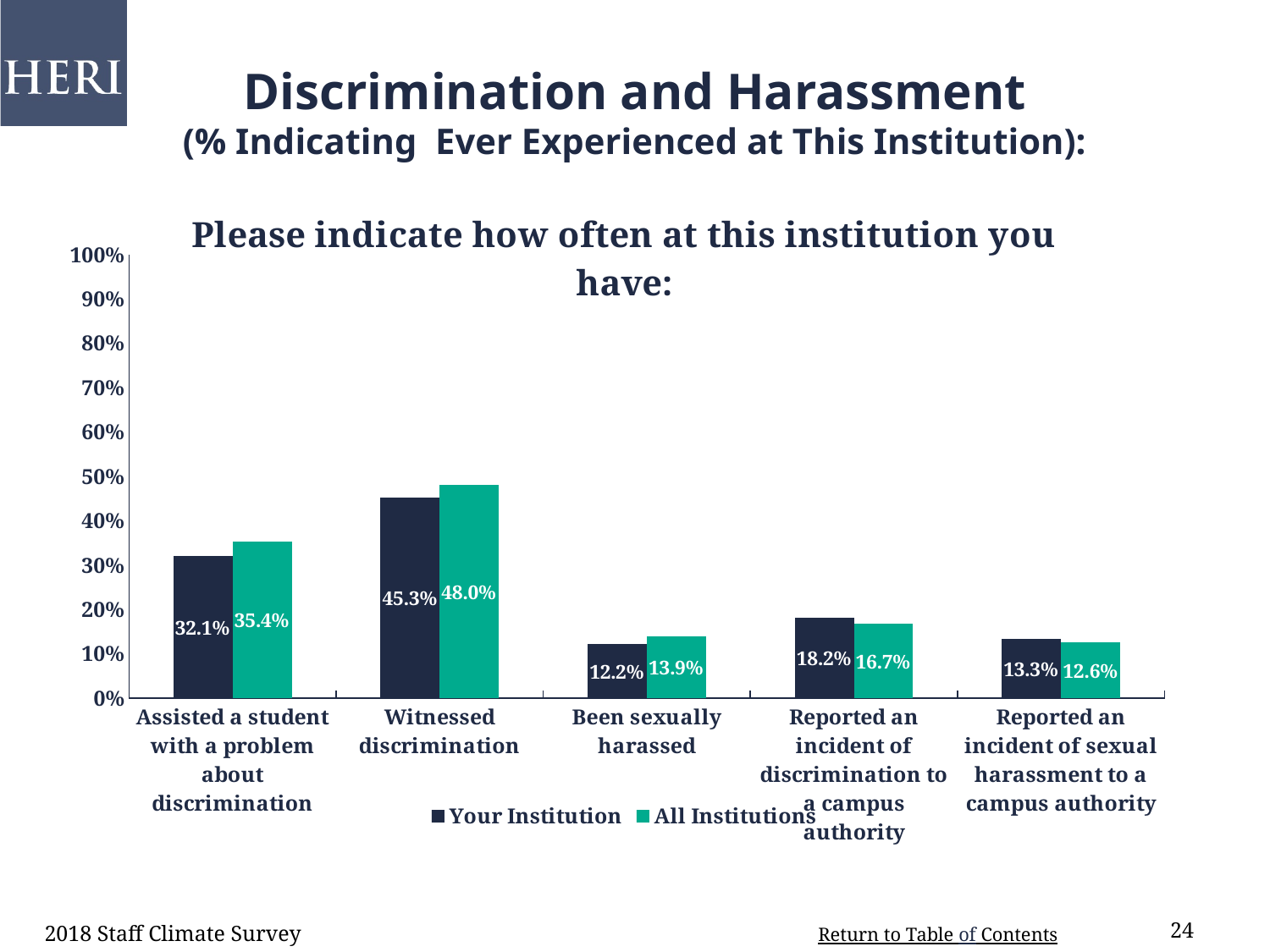
How many series does the legend list? 2 What is the value for "Your Institution" for "Reported an incident of sexual harassment to a campus authority"? 13.3% Which category has the highest value for "All Institutions"? Witnessed discrimination What is the value for "All Institutions" for "Been sexually harassed"? 13.9% Which category has the lowest value for "Your Institution"? Been sexually harassed For "Reported an incident of discrimination to a campus authority", which is larger: "Your Institution" or "All Institutions"? Your Institution What is the value for "Your Institution" for "Witnessed discrimination"? 45.3% What kind of chart is shown on the slide? bar chart What is the difference between "All Institutions" and "Your Institution" for "Assisted a student with a problem about discrimination"? 3.3% Is the value for "All Institutions" for "Witnessed discrimination" greater or less than 40%? greater What are the two series named in the legend? Your Institution and All Institutions How many categories are shown on the x axis? 5